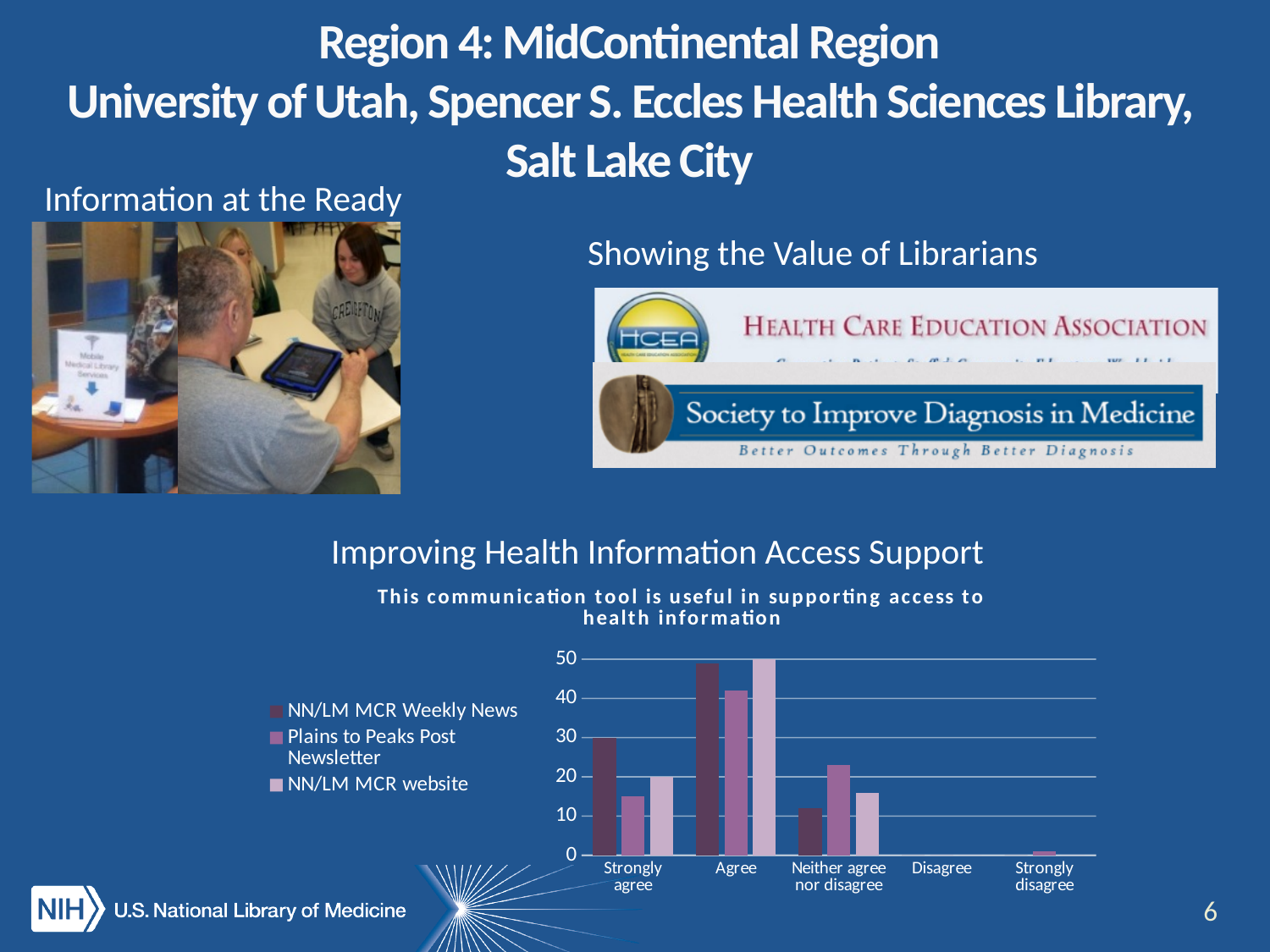
Under 'Strongly agree', which is larger: NN/LM MCR Weekly News or Plains to Peaks Post Newsletter? NN/LM MCR Weekly News What kind of chart is shown under 'Improving Health Information Access Support'? bar chart Is the value for Plains to Peaks Post Newsletter under 'Agree' greater or less than 30? greater For NN/LM MCR website, which response category has the highest bar? Agree How many series does the legend of the bar chart list? 3 How many response categories are shown on the x axis of the bar chart? 5 Is the value for NN/LM MCR Weekly News under 'Strongly agree' greater or less than 20? greater What is the first entry in the bar chart's legend? NN/LM MCR Weekly News Is the value for NN/LM MCR website under 'Neither agree nor disagree' greater or less than 20? less Under 'Neither agree nor disagree', which is larger: Plains to Peaks Post Newsletter or NN/LM MCR Weekly News? Plains to Peaks Post Newsletter What is the title of the bar chart? This communication tool is useful in supporting access to health information For NN/LM MCR Weekly News, which response category has the highest bar? Agree